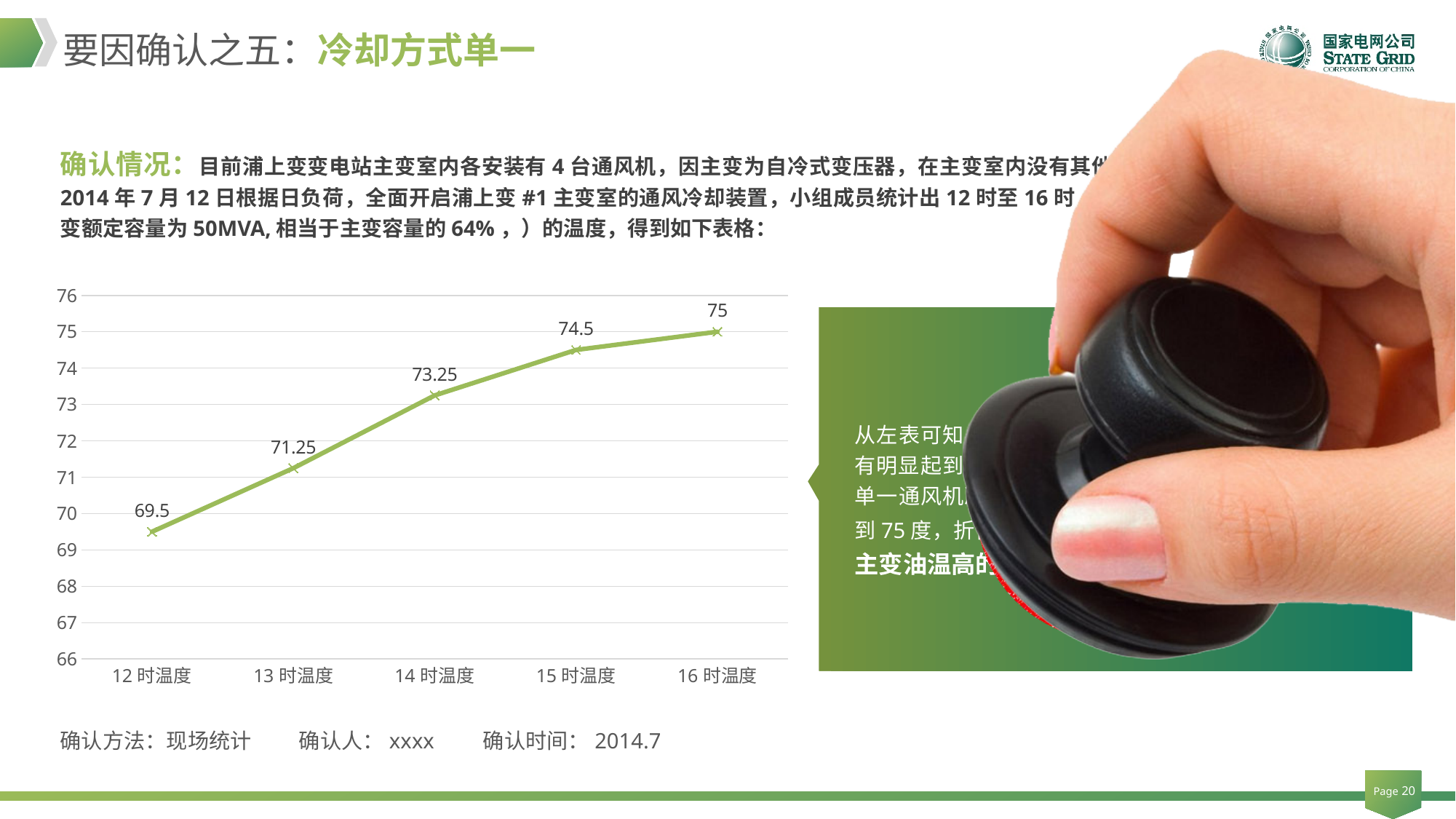
Do the values rise or fall from 12 时温度 to 16 时温度? rise What is the difference between the values for 16 时温度 and 12 时温度? 5.5 Which category has the highest value? 16 时温度 Which is larger, the value for 13 时温度 or the value for 15 时温度? 15 时温度 Is the value for 13 时温度 greater or less than 72? less What kind of chart is shown on the slide? line chart What is the difference between the values for 15 时温度 and 14 时温度? 1.25 Which category has the lowest value? 12 时温度 What is the value for 16 时温度? 75 What is the value for 12 时温度? 69.5 What is the value for 14 时温度? 73.25 How many data points are plotted on the chart? 5